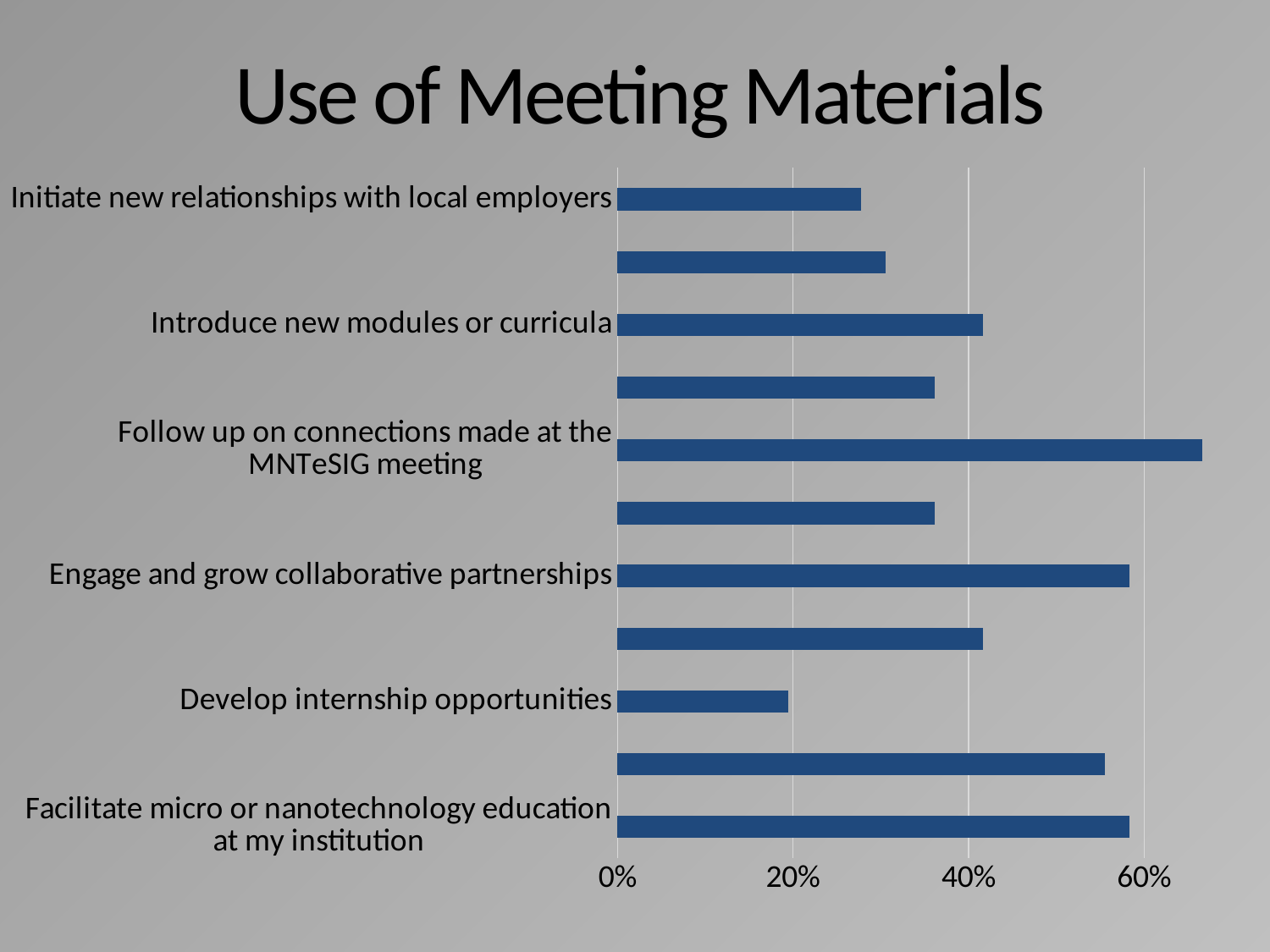
Is the value for 'Initiate new relationships with local employers' greater or less than 40%? less Which labeled category has the longest bar? Follow up on connections made at the MNTeSIG meeting Is the value for 'Introduce new modules or curricula' greater or less than 20%? greater Is the value for 'Follow up on connections made at the MNTeSIG meeting' greater or less than 60%? greater What is the title of the chart? Use of Meeting Materials Which is larger: the value for 'Facilitate micro or nanotechnology education at my institution' or the value for 'Develop internship opportunities'? Facilitate micro or nanotechnology education at my institution How many bars are plotted in the chart? 11 What kind of chart is shown on the slide? bar chart Which is larger: the value for 'Introduce new modules or curricula' or the value for 'Initiate new relationships with local employers'? Introduce new modules or curricula Which labeled category has the shortest bar? Develop internship opportunities